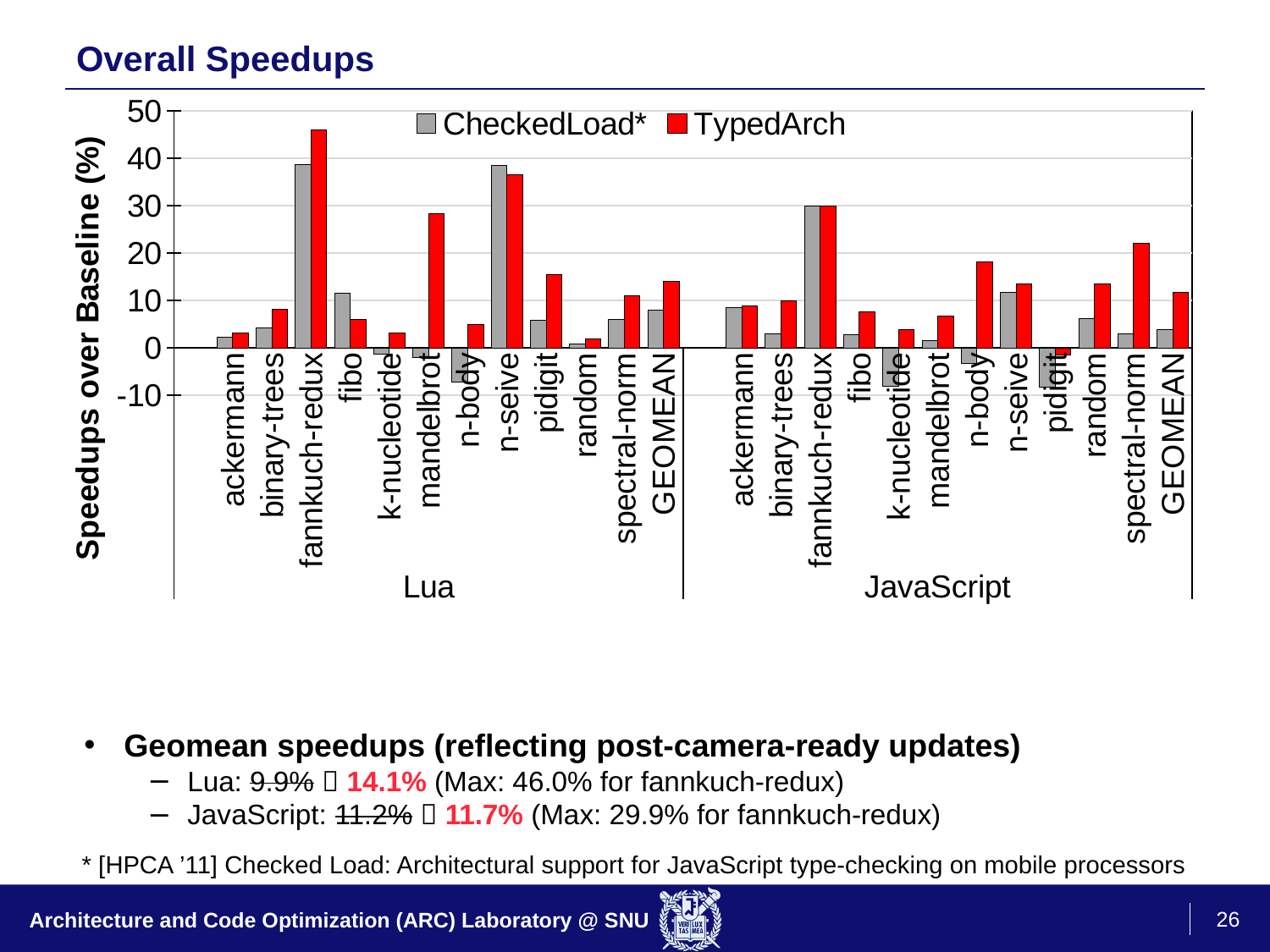
Which Lua benchmark has the highest TypedArch speedup? fannkuch-redux According to the slide text, what is the TypedArch GEOMEAN speedup for Lua? 14.1% How many series does the chart legend list? 2 Is the CheckedLoad* speedup for k-nucleotide in the JavaScript group greater or less than 0? less Which JavaScript benchmark has the highest TypedArch speedup? fannkuch-redux Is the TypedArch speedup for fannkuch-redux in the Lua group greater or less than 40? greater Which JavaScript benchmark has the lowest TypedArch speedup? pidigit How many benchmark categories (including GEOMEAN) are plotted in the Lua group? 12 For mandelbrot in the Lua group, which series has the larger speedup, CheckedLoad* or TypedArch? TypedArch What kind of chart is shown on the slide? bar chart What are the two series named in the chart legend? CheckedLoad* and TypedArch Is the TypedArch speedup for mandelbrot in the Lua group greater or less than 20? greater